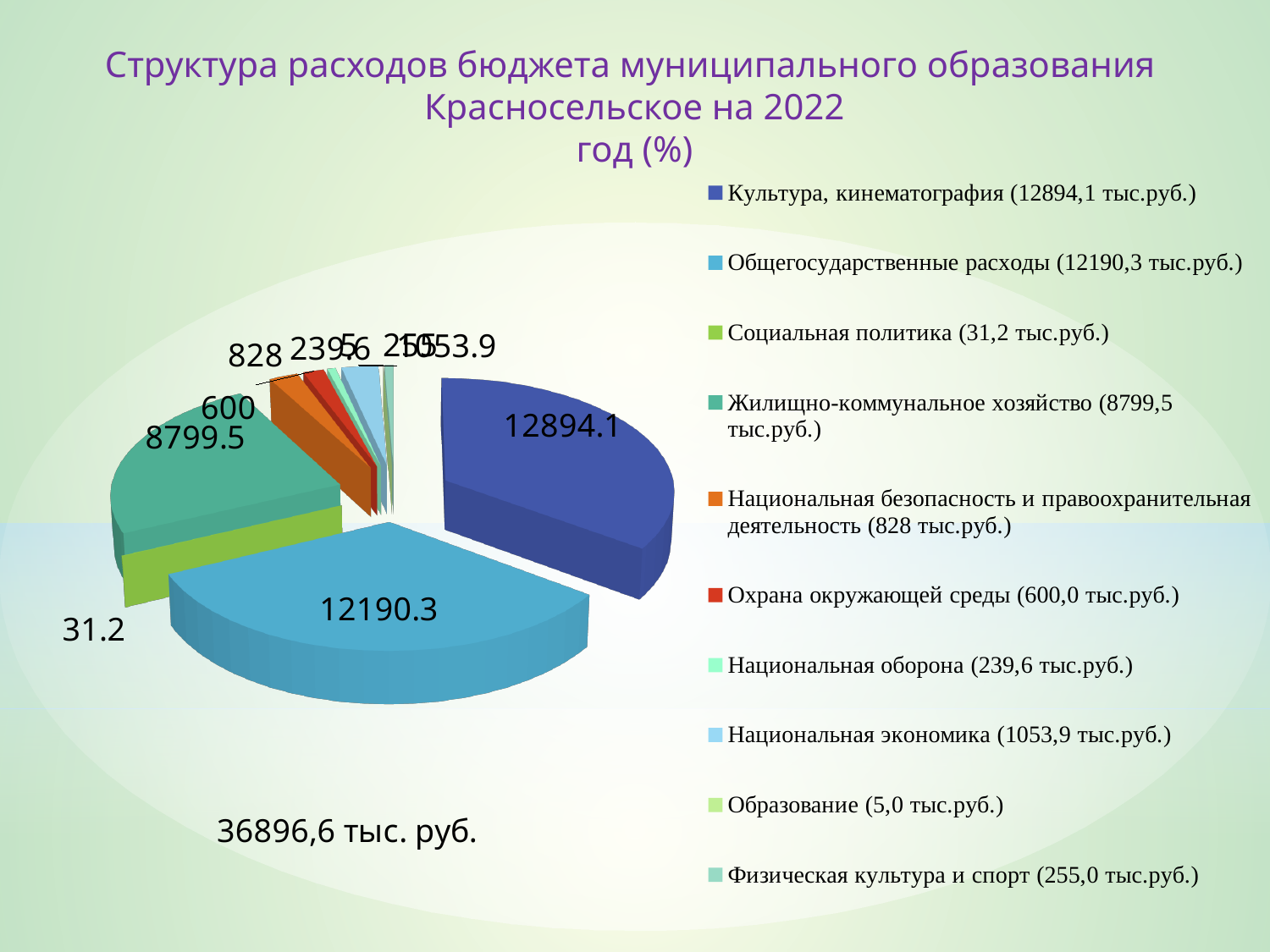
What is the data label value for Общегосударственные расходы? 12190.3 What kind of chart is shown on the slide? Pie chart Which category has the largest slice in the pie chart? Культура, кинематография What is the data label value for Социальная политика? 31.2 Which category has the smallest value in the pie chart? Образование What is the difference between the values for Жилищно-коммунальное хозяйство (8799.5) and Национальная безопасность и правоохранительная деятельность (828)? 7971.5 What is the difference between the values for Культура, кинематография (12894.1) and Общегосударственные расходы (12190.3)? 703.8 What is the data label value for Культура, кинематография? 12894.1 How many categories does the legend of the pie chart list? 10 What is the data label value for Жилищно-коммунальное хозяйство? 8799.5 What total amount is printed below the pie chart? 36896,6 тыс. руб. Which is larger: Культура, кинематография or Общегосударственные расходы? Культура, кинематография